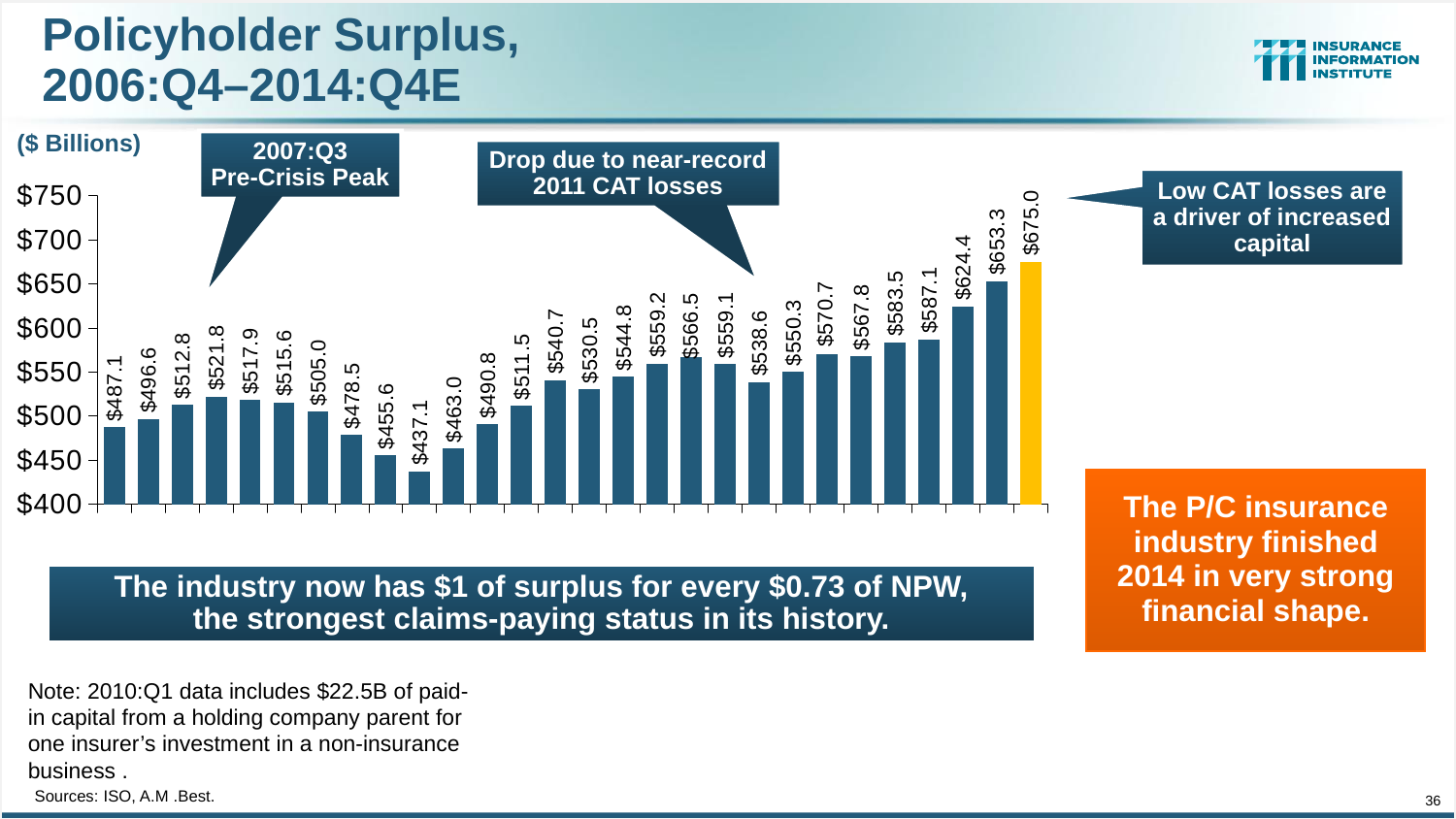
Overall, do the values rise or fall from the first bar to the last bar? Rise How many bars are plotted on the chart? 28 What colour is the final (2014:Q4E) bar on the chart? Yellow What is the value of the first bar (2006:Q4) on the chart? $487.1 What kind of chart is shown on the slide? Bar chart Which is larger, the first bar ($487.1) or the last bar ($675.0)? The last bar ($675.0) What is the value of the last bar (2014:Q4E) on the chart? $675.0 How much higher is the final bar ($675.0) than the bar just before it ($653.3)? $21.7 What is the difference between the highest and lowest values on the chart? $237.9 What is the highest policyholder surplus value shown on the chart? $675.0 What is the lowest policyholder surplus value shown on the chart? $437.1 What is the value of the bar labelled as the 2007:Q3 Pre-Crisis Peak? $521.8